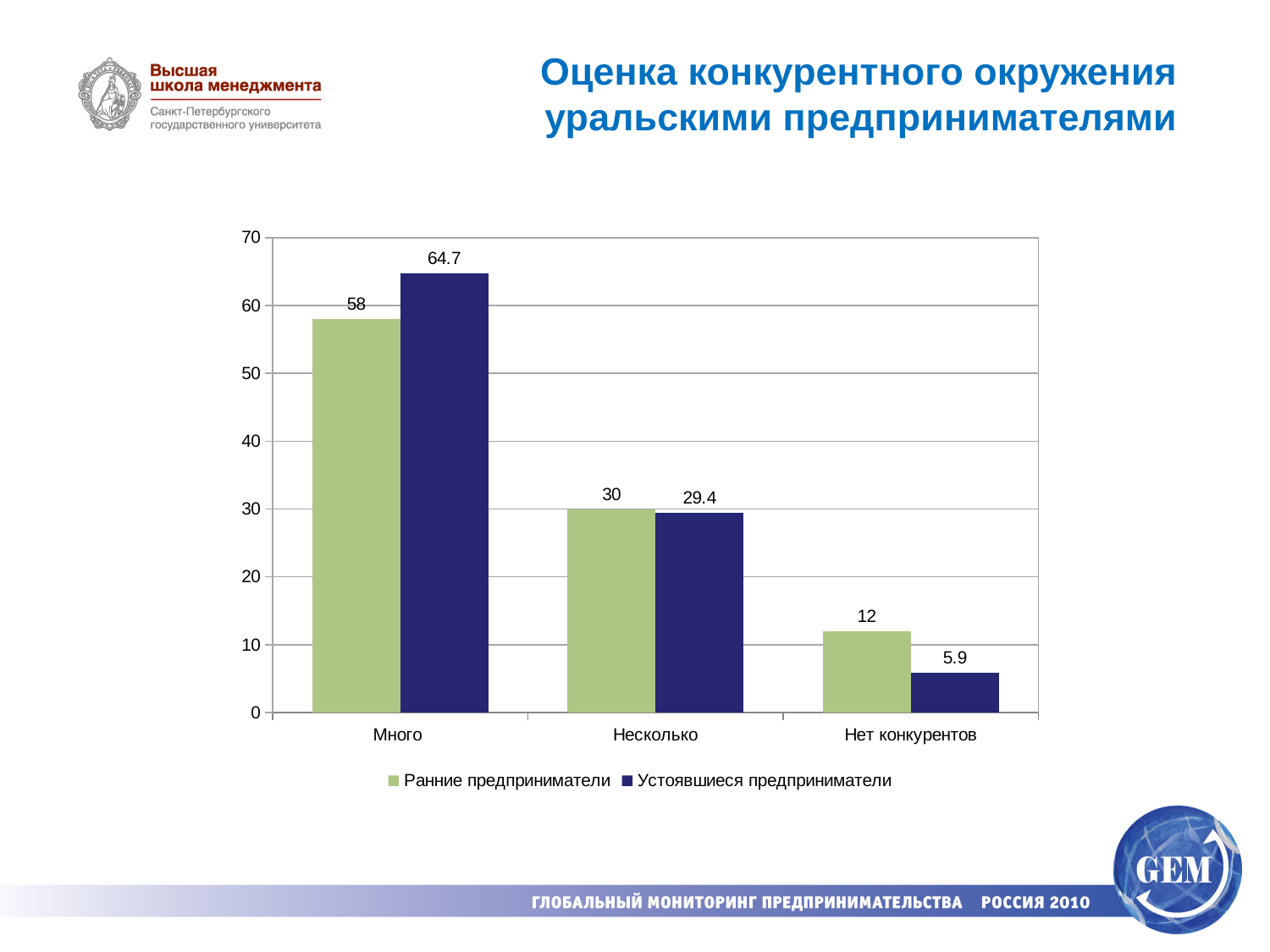
In the Нет конкурентов category, which series has the larger value? Ранние предприниматели How many series does the legend list? 2 What is the difference between Устоявшиеся предприниматели and Ранние предприниматели in the Много category? 6.7 What is the value for Устоявшиеся предприниматели in the Нет конкурентов category? 5.9 Which category has the highest value for Устоявшиеся предприниматели? Много Do the values for Ранние предприниматели rise or fall from Много to Нет конкурентов? fall Which category has the lowest value for Ранние предприниматели? Нет конкурентов What kind of chart is shown on the slide? bar chart What is the value for Ранние предприниматели in the Много category? 58 How many categories are shown on the x axis? 3 Is the value for Ранние предприниматели in the Несколько category greater or less than 20? greater What is the value for Устоявшиеся предприниматели in the Несколько category? 29.4